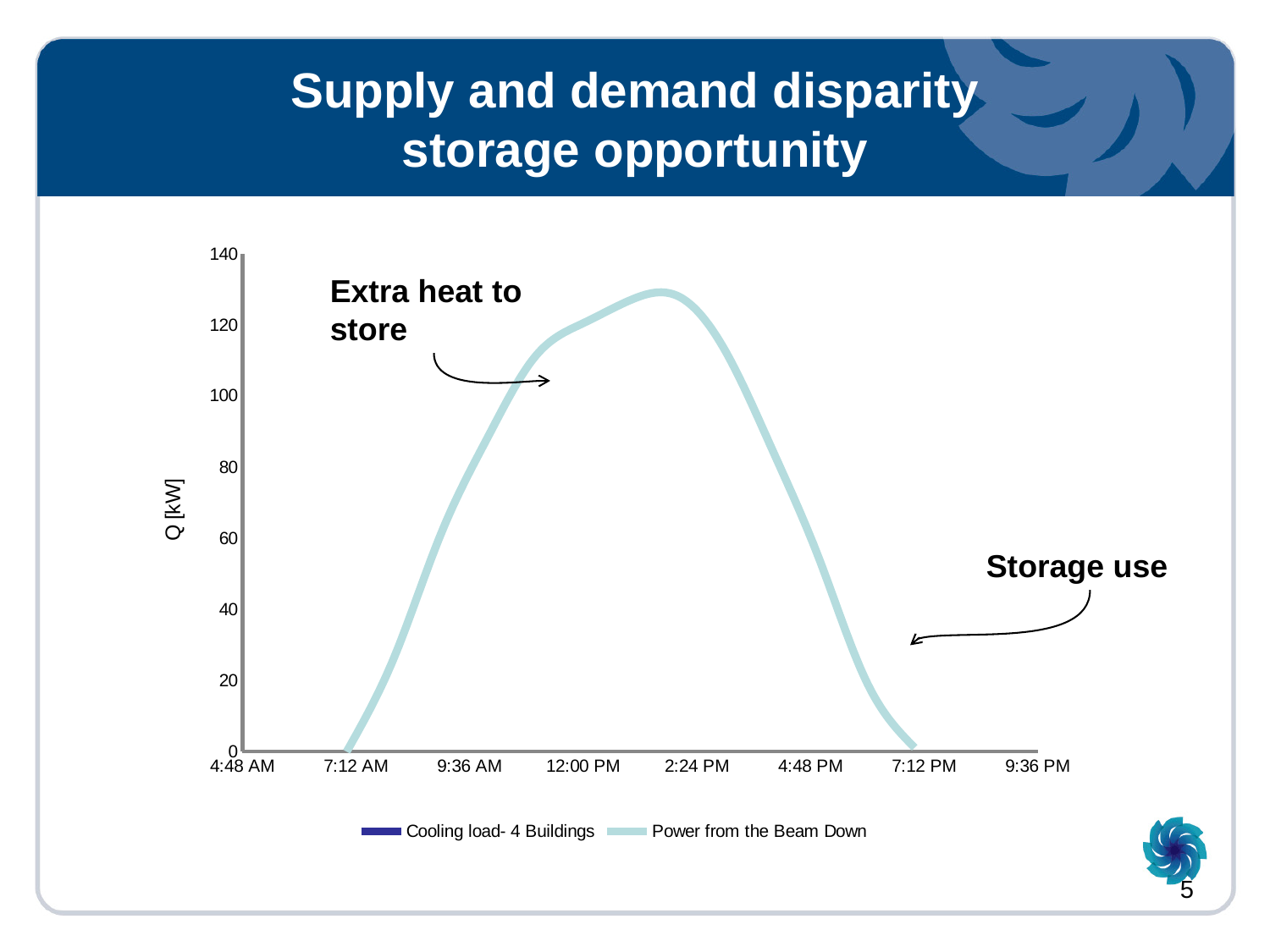
What is the value of Power from the Beam Down at 7:12 AM? 0 Is the value of Power from the Beam Down at 12:00 PM greater or less than 100? greater What kind of chart is shown on the slide? line chart How many time labels are shown on the horizontal axis? 8 How many series does the legend list? 2 Does the Power from the Beam Down line rise or fall between 2:24 PM and 7:12 PM? fall Is the peak value of Power from the Beam Down greater or less than 120? greater Does the Power from the Beam Down line rise or fall between 7:12 AM and 12:00 PM? rise Is the value of Power from the Beam Down at 4:48 PM greater or less than 80? less What is the label on the vertical axis? Q [kW] Which legend entry is drawn in light blue? Power from the Beam Down